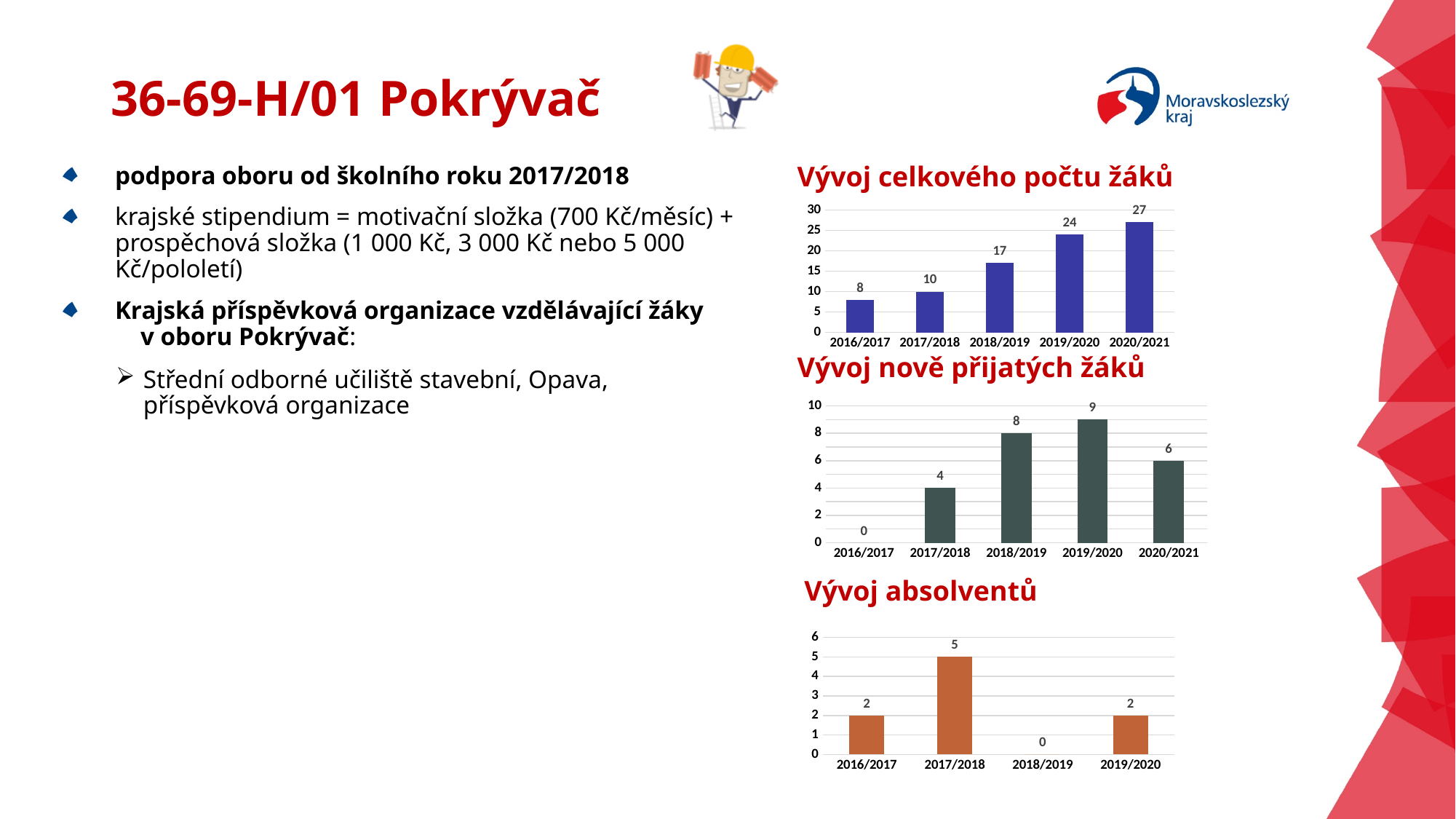
In the chart 'Vývoj nově přijatých žáků', what is the value for 2019/2020? 9 In the chart 'Vývoj celkového počtu žáků', what is the difference between the values for 2020/2021 and 2016/2017? 19 In the chart 'Vývoj absolventů', how many school years are shown on the x axis? 4 In the chart 'Vývoj celkového počtu žáků', do the values rise or fall from 2016/2017 to 2020/2021? rise In the chart 'Vývoj nově přijatých žáků', which school year has the lowest value? 2016/2017 In the chart 'Vývoj absolventů', what is the difference between the values for 2017/2018 and 2019/2020? 3 In the chart 'Vývoj celkového počtu žáků', which school year has the highest value? 2020/2021 In the chart 'Vývoj celkového počtu žáků', what is the value for 2018/2019? 17 What kind of chart is 'Vývoj absolventů'? bar chart In the chart 'Vývoj absolventů', what is the value for 2017/2018? 5 In the chart 'Vývoj nově přijatých žáků', which is larger, the value for 2018/2019 or the value for 2020/2021? 2018/2019 In the chart 'Vývoj nově přijatých žáků', how many school years are shown on the x axis? 5